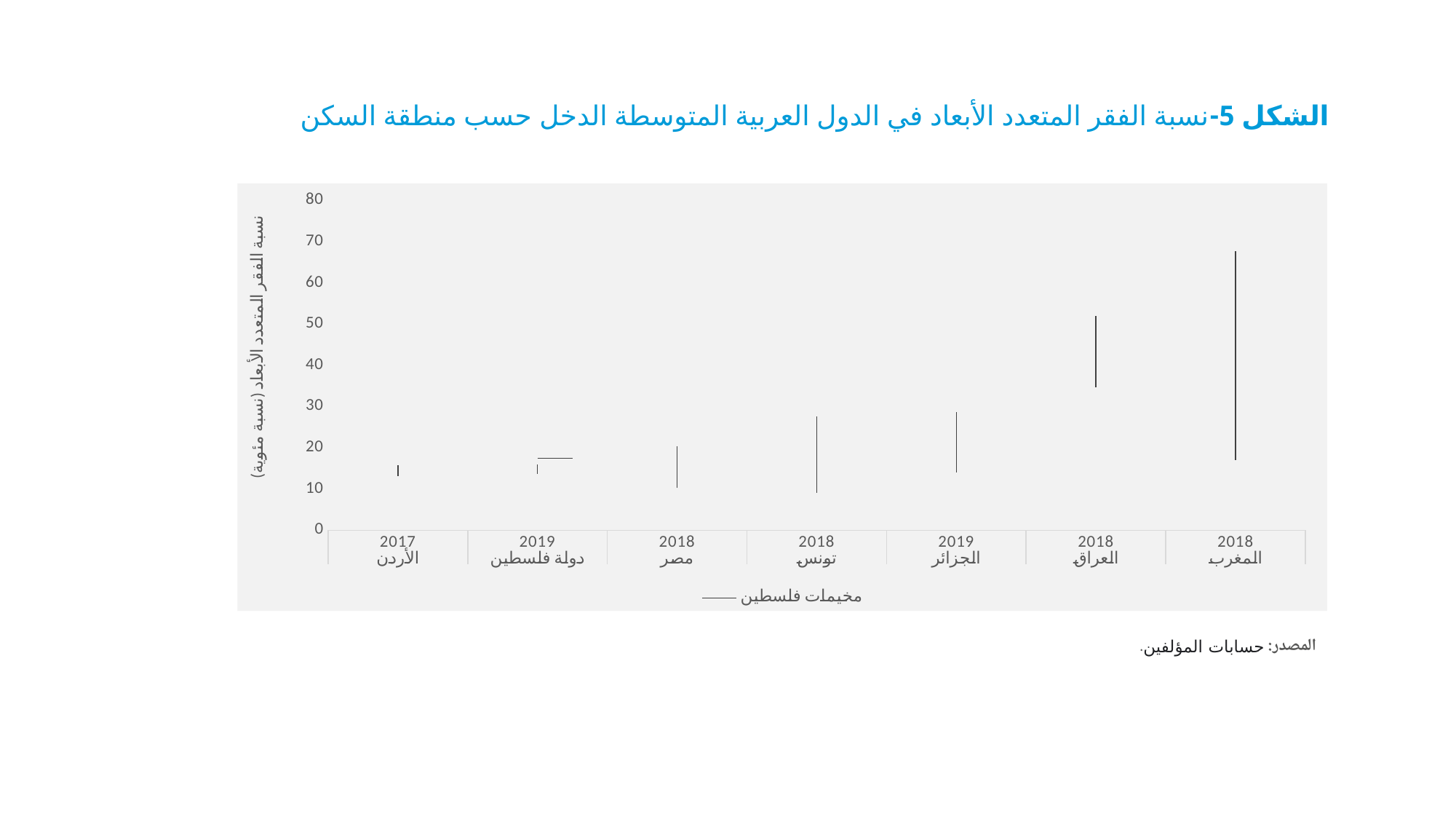
Which reaches a higher value on the chart, الأردن (2017) or الجزائر (2019)? الجزائر What is the legend entry shown below the chart? مخيمات فلسطين Which country has the highest value reached on the chart? المغرب How many countries are shown along the x axis of the chart? 7 What is the title of the chart? الشكل 5- نسبة الفقر المتعدد الأبعاد في الدول العربية المتوسطة الدخل حسب منطقة السكن How many entries does the chart's legend list? 1 Is the lowest value for العراق (2018) greater or less than 40? less Is the value for دولة فلسطين (2019) greater or less than 20? less Is the highest value for تونس (2018) greater or less than 20? greater Which reaches a higher value on the chart, المغرب (2018) or العراق (2018)? المغرب